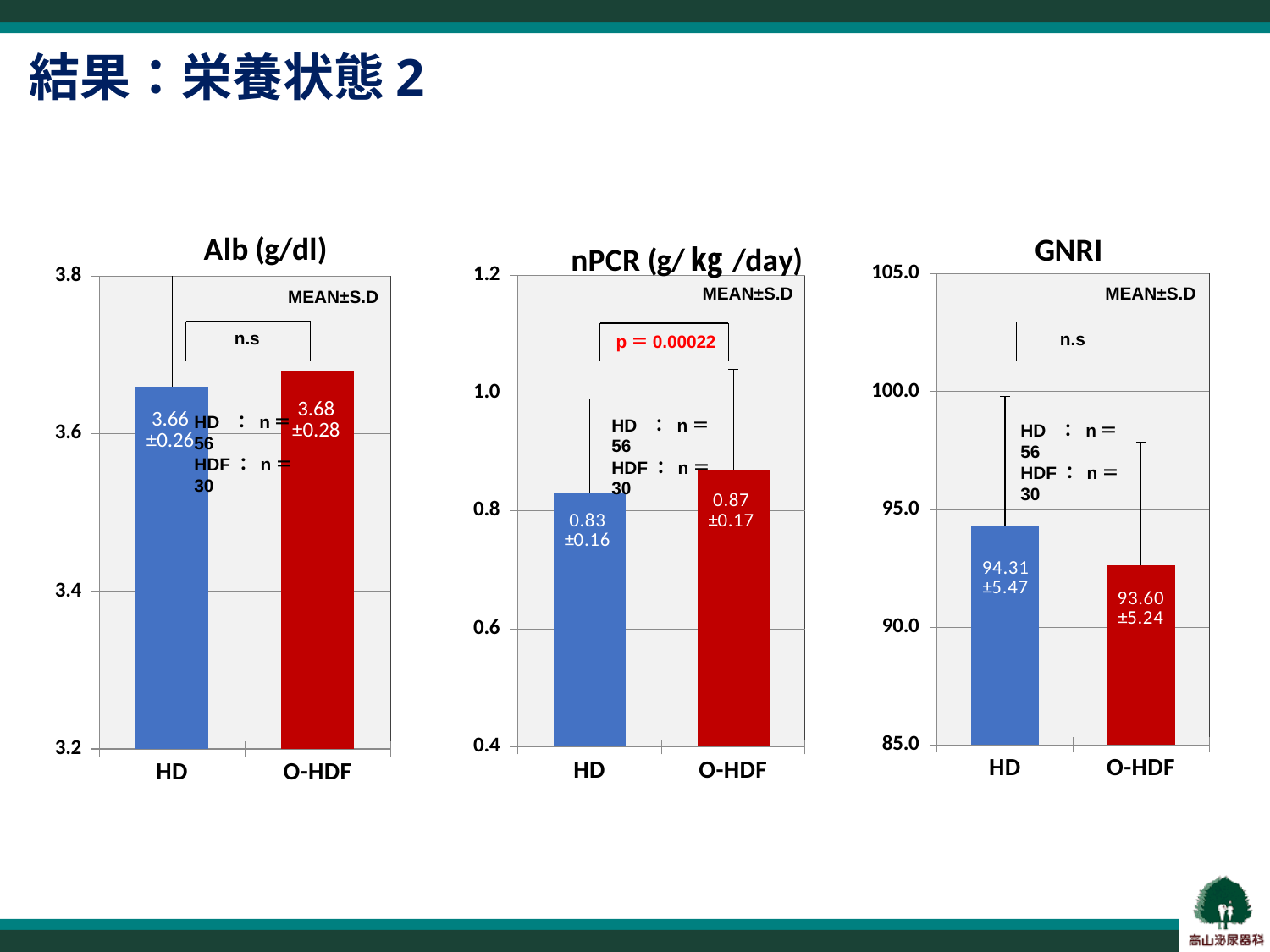
What type of chart is the nPCR (g/kg/day) chart? Bar chart In the GNRI chart, which group has the higher mean value, HD or O-HDF? HD In the nPCR (g/kg/day) chart, what is the difference between the O-HDF and HD mean values? 0.04 In the nPCR (g/kg/day) chart, what is the mean value for O-HDF? 0.87 How many bars are plotted in the Alb (g/dl) chart? 2 In the nPCR (g/kg/day) chart, what is the mean value for HD? 0.83 In the GNRI chart, what is the difference between the HD and O-HDF mean values? 0.71 In the Alb (g/dl) chart, what is the mean value for HD? 3.66 In the GNRI chart, what is the mean value for HD? 94.31 What p value is shown in the nPCR (g/kg/day) chart? p = 0.00022 In the Alb (g/dl) chart, what is the mean value for O-HDF? 3.68 In the GNRI chart, what is the mean value for O-HDF? 93.60